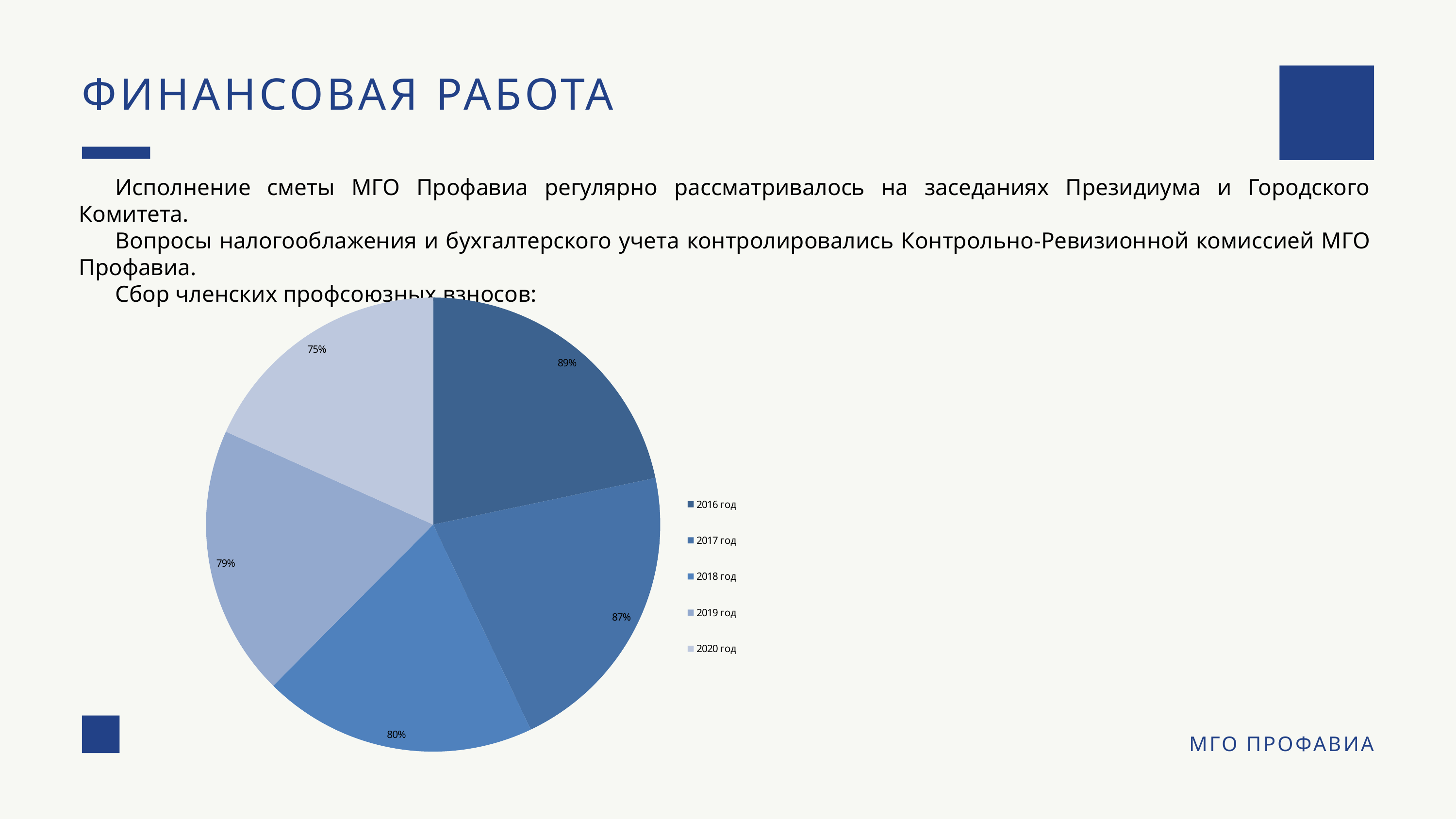
What is the value labelled for 2020 год in the pie chart? 75% What is the value labelled for 2019 год in the pie chart? 79% What is the value labelled for 2016 год in the pie chart? 89% Which year has the highest labelled value in the pie chart? 2016 год What is the value labelled for 2017 год in the pie chart? 87% What is the difference between the labelled values for 2016 год and 2020 год? 14% How many slices does the pie chart have? 5 What is the value labelled for 2018 год in the pie chart? 80% Do the labelled values rise or fall from 2016 год to 2020 год? fall Which has the larger labelled value, 2017 год or 2018 год? 2017 год Which year has the lowest labelled value in the pie chart? 2020 год What type of chart is shown on the slide? pie chart